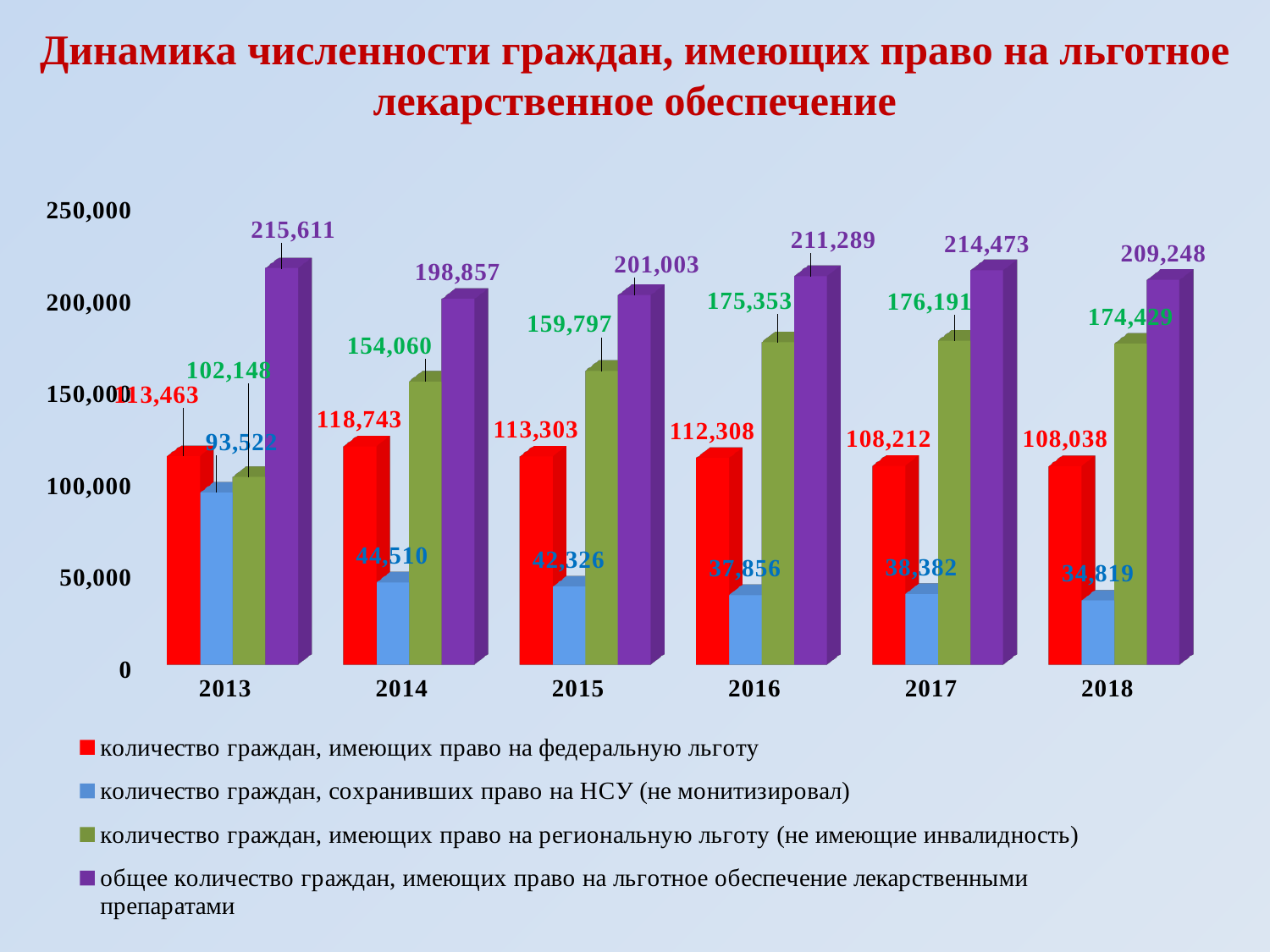
What is the difference between the red series (право на федеральную льготу) values for 2014 and 2018? 10,705 What kind of chart is shown on the slide? bar chart What is the value of the blue series (сохранивших право на НСУ) for 2018? 34,819 What is the value of the green series (право на региональную льготу) for 2016? 175,353 Is the value of the red series (право на федеральную льготу) for 2016 greater or less than 100,000? greater In which year is the blue series (сохранивших право на НСУ) lowest? 2018 Does the blue series (сохранивших право на НСУ) rise or fall from 2013 to 2018? fall How many series does the legend list? 4 How many years are shown on the x axis? 6 Which year has the larger value for the green series (право на региональную льготу): 2017 or 2018? 2017 What is the value of the purple series (общее количество граждан) for 2013? 215,611 In which year is the purple series (общее количество граждан) highest? 2013